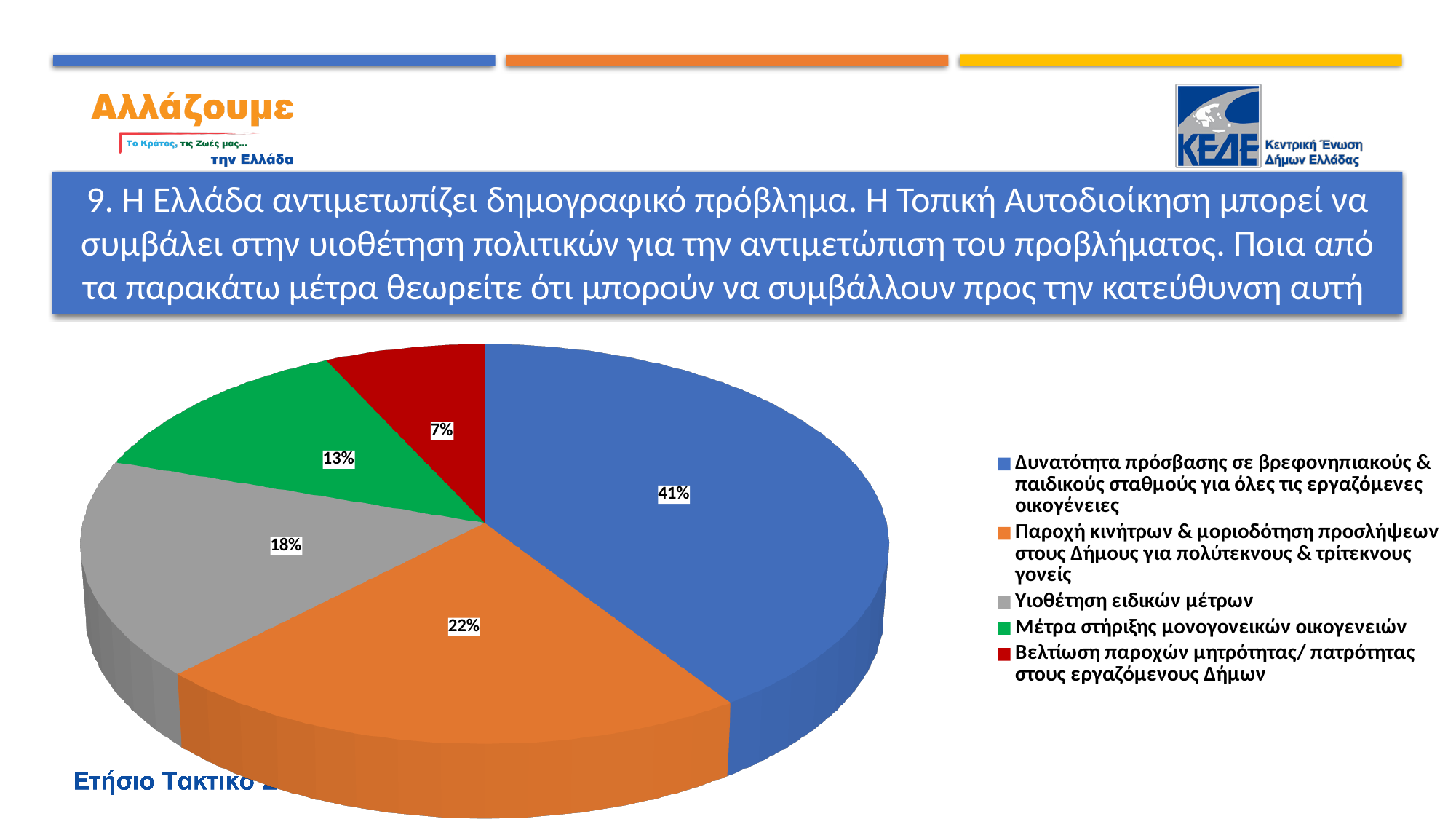
What percentage is shown for "Υιοθέτηση ειδικών μέτρων"? 18% Which is larger: the share for "Υιοθέτηση ειδικών μέτρων" or the share for "Μέτρα στήριξης μονογονεικών οικογενειών"? Υιοθέτηση ειδικών μέτρων What percentage is shown for "Μέτρα στήριξης μονογονεικών οικογενειών"? 13% What colour is the slice labelled 7%? Red What is the difference in percentage points between the largest slice (41%) and the slice for "Παροχή κινήτρων & μοριοδότηση προσλήψεων" (22%)? 19 percentage points What percentage is shown for "Παροχή κινήτρων & μοριοδότηση προσλήψεων στους Δήμους για πολύτεκνους & τρίτεκνους γονείς"? 22% Which category has the smallest share of the pie? Βελτίωση παροχών μητρότητας/ πατρότητας στους εργαζόμενους Δήμων What kind of chart is shown on the slide? Pie chart What percentage is shown for "Βελτίωση παροχών μητρότητας/ πατρότητας στους εργαζόμενους Δήμων"? 7% How many slices does the pie chart have? 5 Which category has the largest share of the pie? Δυνατότητα πρόσβασης σε βρεφονηπιακούς & παιδικούς σταθμούς για όλες τις εργαζόμενες οικογένειες What colour is the slice for "Υιοθέτηση ειδικών μέτρων"? Grey